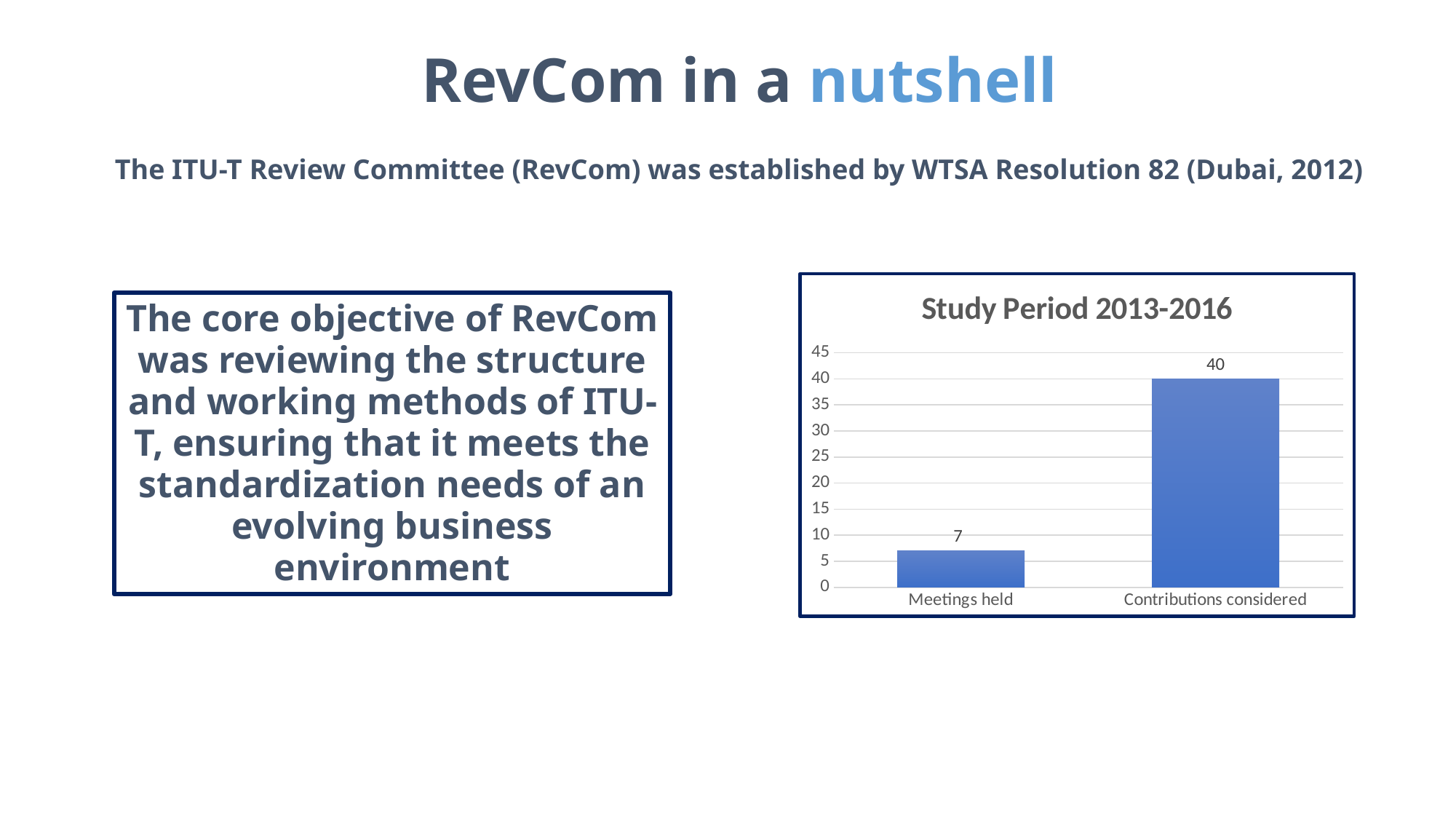
Is the value for Meetings held greater or less than 10? less What is the title of the chart? Study Period 2013-2016 Which category has the lowest value? Meetings held How many categories are shown in the chart? 2 What kind of chart is shown on the slide? bar chart What is the value for Contributions considered? 40 Which is larger, Meetings held or Contributions considered? Contributions considered What is the value for Meetings held? 7 What is the difference between Contributions considered and Meetings held? 33 Is the value for Contributions considered greater or less than 35? greater What is the highest value shown on the vertical axis? 45 Which category has the highest value? Contributions considered